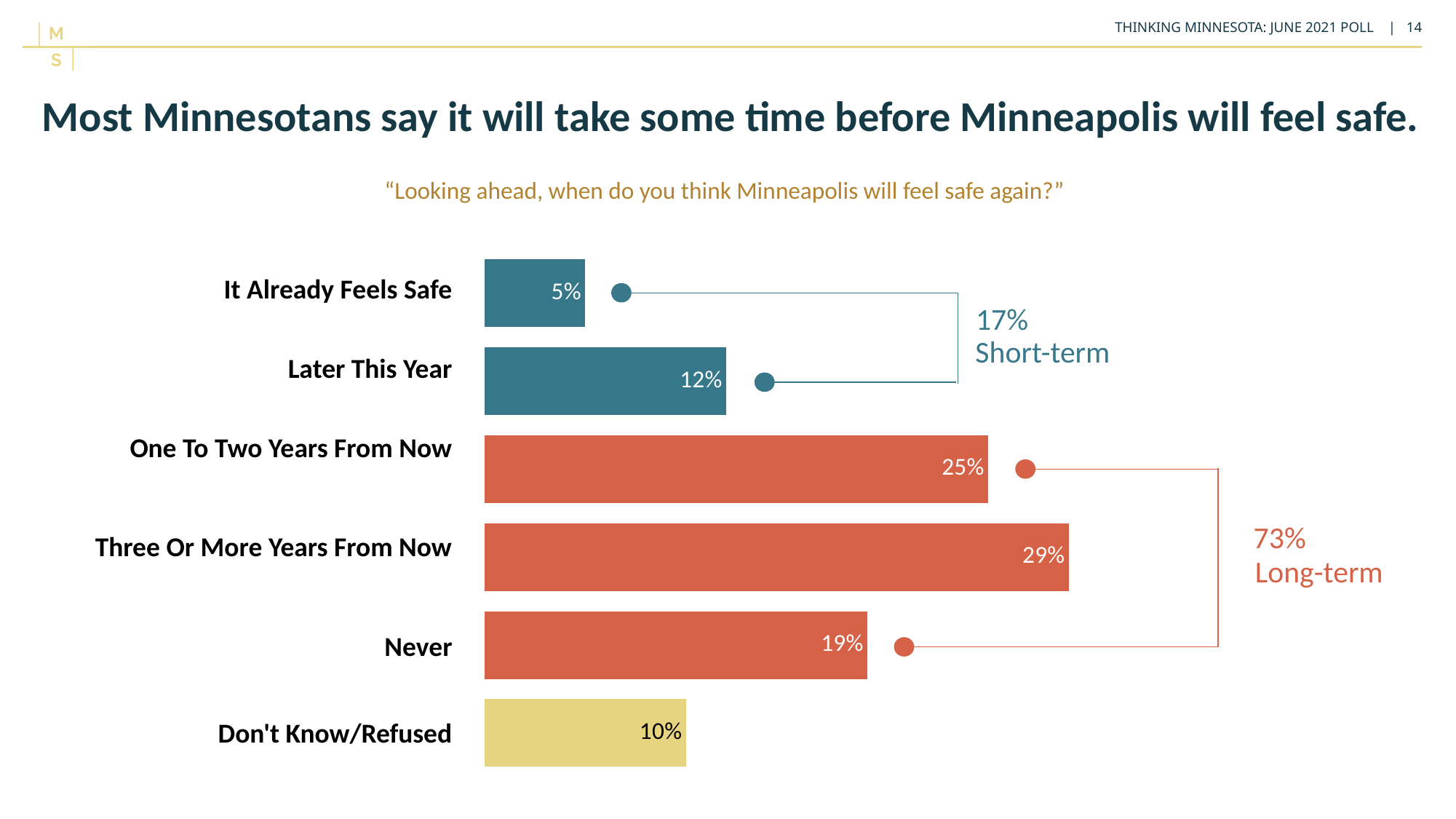
What is the value for "Three Or More Years From Now"? 29% What is the difference between "One To Two Years From Now" and "Later This Year"? 13 percentage points What percentage of respondents said Minneapolis already feels safe? 5% What combined percentage is labelled as "Short-term"? 17% How many response categories are shown in the chart? 6 What percentage of respondents answered "Never"? 19% What combined percentage is labelled as "Long-term"? 73% Which response category has the highest value? Three Or More Years From Now What kind of chart is shown on the slide? Bar chart Which response category has the lowest value? It Already Feels Safe What is the value for "Don't Know/Refused"? 10% Which is larger, the value for "Never" or the value for "Later This Year"? Never